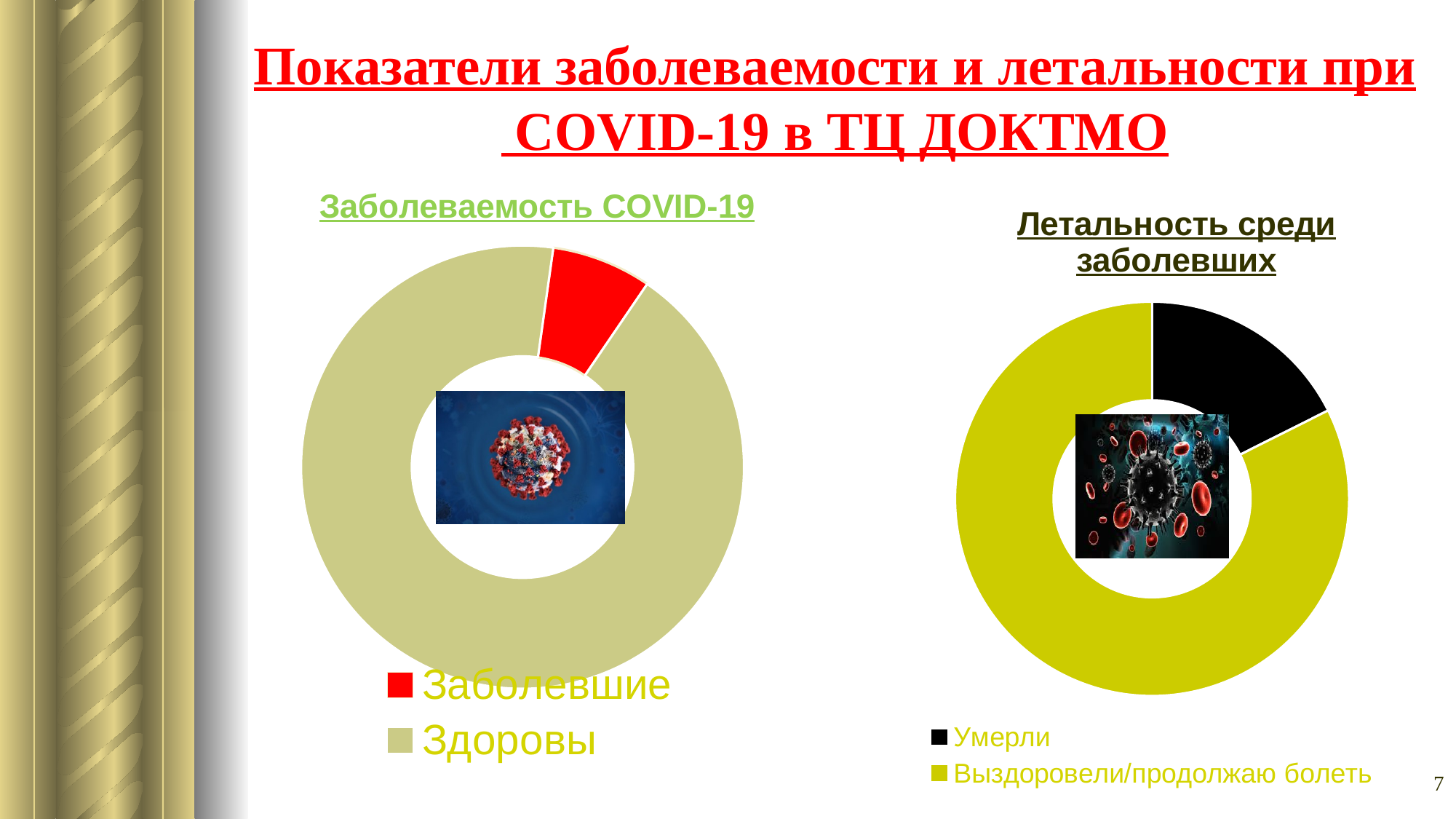
In the "Заболеваемость COVID-19" chart, which slice is larger: Заболевшие or Здоровы? Здоровы What kind of chart is the "Заболеваемость COVID-19" chart? Pie (doughnut) chart In the "Летальность среди заболевших" chart, what colour is the Умерли slice? Black What is the title of the chart on the left side of the slide? Заболеваемость COVID-19 In the "Летальность среди заболевших" chart, how many slices are there? 2 In the "Летальность среди заболевших" chart, which category has the largest slice? Выздоровели/продолжаю болеть In the "Заболеваемость COVID-19" chart, which category has the smallest slice? Заболевшие What kind of chart is the "Летальность среди заболевших" chart? Pie (doughnut) chart In the "Летальность среди заболевших" chart, which slice is larger: Умерли or Выздоровели/продолжаю болеть? Выздоровели/продолжаю болеть In the "Заболеваемость COVID-19" chart, which category has the largest slice? Здоровы In the "Летальность среди заболевших" chart, which category has the smallest slice? Умерли In the "Заболеваемость COVID-19" chart, how many slices are there? 2